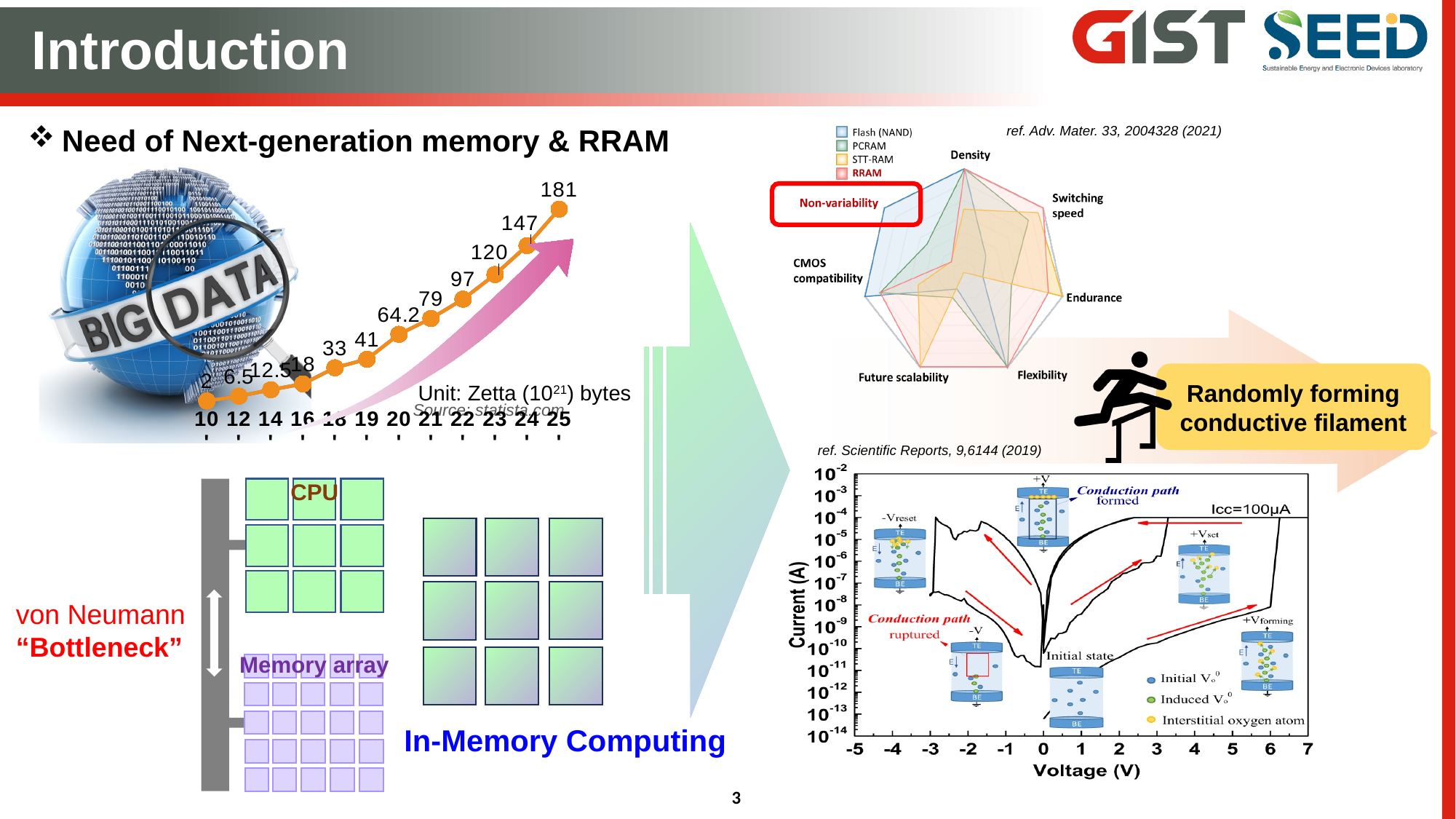
On the big data growth line chart, what is the value for 20? 64.2 On the big data growth line chart, which is larger, the value for 18 or the value for 19? 19 How many data points are plotted on the big data growth line chart? 12 What kind of chart is the big data growth chart? line chart On the big data growth line chart, do the values rise or fall from 10 to 25? rise On the big data growth line chart, what is the value for 24? 147 On the big data growth line chart, what is the difference between the values for 25 and 24? 34 On the big data growth line chart, what is the difference between the values for 23 and 22? 23 On the big data growth line chart, what is the value for 25? 181 On the big data growth line chart, which year has the lowest value? 10 On the big data growth line chart, which year has the highest value? 25 How many memory types does the legend of the radar chart list? 4